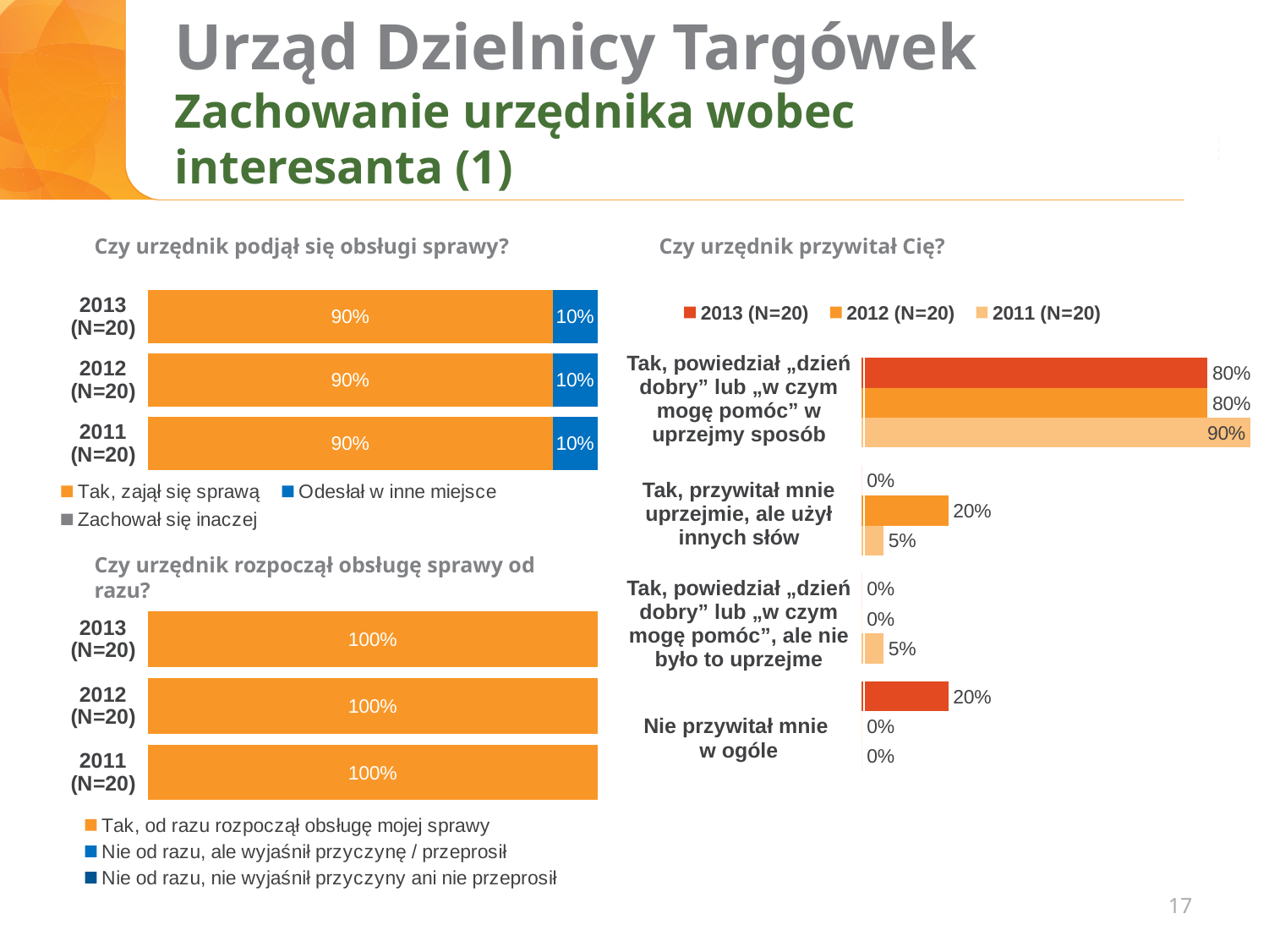
In the chart 'Czy urzędnik przywitał Cię?', which series has the highest value in the category 'Tak, powiedział „dzień dobry” lub „w czym mogę pomóc” w uprzejmy sposób'? 2011 (N=20) In the chart 'Czy urzędnik podjął się obsługi sprawy?', how many series does the legend list? 3 In the chart 'Czy urzędnik podjął się obsługi sprawy?', what is the value for 'Tak, zajął się sprawą' in 2013 (N=20)? 90% In the chart 'Czy urzędnik przywitał Cię?', what is the value for 2011 (N=20) in the category 'Tak, powiedział „dzień dobry” lub „w czym mogę pomóc” w uprzejmy sposób'? 90% In the chart 'Czy urzędnik rozpoczął obsługę sprawy od razu?', how many year categories are shown? 3 In the chart 'Czy urzędnik rozpoczął obsługę sprawy od razu?', what is the value for 'Tak, od razu rozpoczął obsługę mojej sprawy' in 2012 (N=20)? 100% In the chart 'Czy urzędnik przywitał Cię?', what is the value for 2012 (N=20) in the category 'Tak, przywitał mnie uprzejmie, ale użył innych słów'? 20% In the chart 'Czy urzędnik podjął się obsługi sprawy?', what is the value for 'Odesłał w inne miejsce' in 2011 (N=20)? 10% In the chart 'Czy urzędnik przywitał Cię?', what is the value for 2013 (N=20) in the category 'Nie przywitał mnie w ogóle'? 20% What kind of chart is 'Czy urzędnik rozpoczął obsługę sprawy od razu?' Bar chart In the chart 'Czy urzędnik przywitał Cię?', what is the difference between the 2011 (N=20) and 2013 (N=20) values in the category 'Tak, powiedział „dzień dobry” lub „w czym mogę pomóc” w uprzejmy sposób'? 10% In the chart 'Czy urzędnik podjął się obsługi sprawy?', what is the total of the stacked bar for 2012 (N=20)? 100%